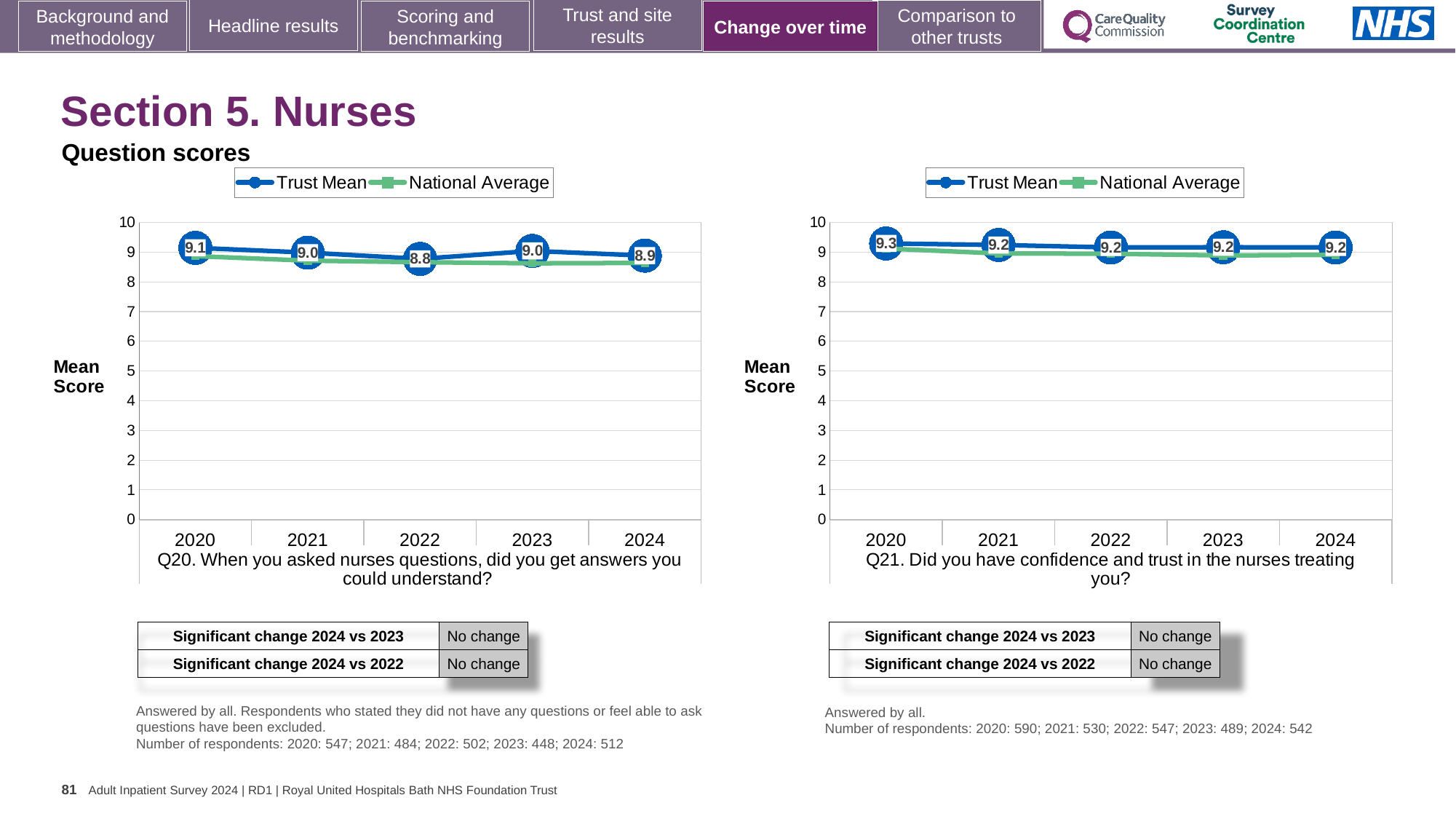
How many years are plotted on the x axis of the Q21 chart on the right? 5 In the Q21 chart on the right, what is the Trust Mean score for 2020? 9.3 In the Q21 chart on the right, what is the difference between the Trust Mean scores for 2020 and 2024? 0.1 How many series does the legend of the Q20 chart on the left list? 2 In the Q21 chart on the right, which year has the highest Trust Mean score? 2020 What kind of chart is used for Q20 on the left? Line chart Which is larger: the Trust Mean score for 2024 in the Q20 chart or the Trust Mean score for 2024 in the Q21 chart? Q21 chart (9.2) In the Q20 chart on the left, which year has the lowest Trust Mean score? 2022 In the Q20 chart on the left, is the National Average value for 2022 greater or less than 8? greater In the Q20 chart on the left, what is the difference between the Trust Mean scores for 2020 and 2022? 0.3 In the Q20 chart on the left, which year has the highest Trust Mean score? 2020 In the Q20 chart on the left, what is the Trust Mean score for 2022? 8.8